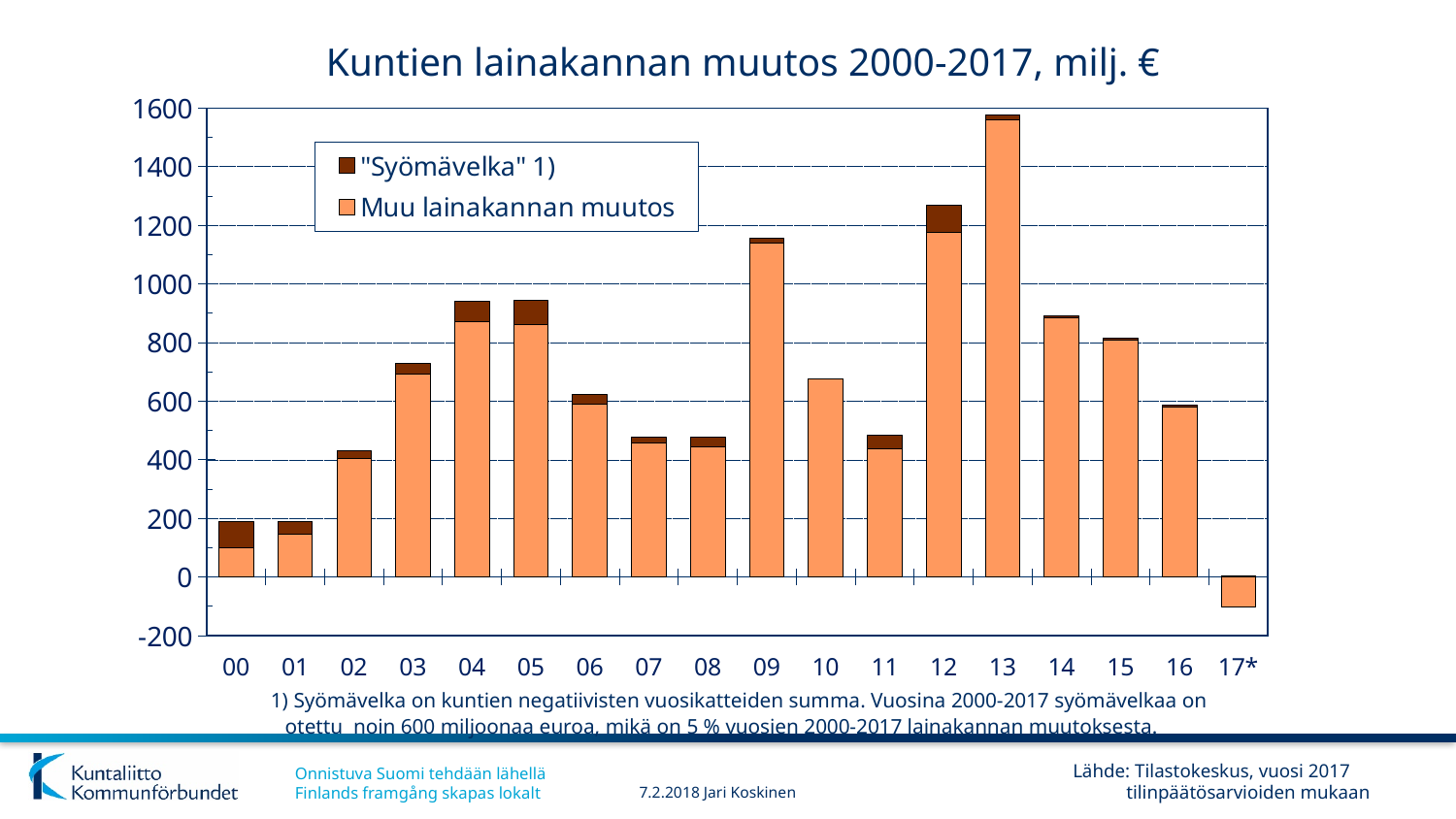
Which year has the highest total change in loan stock? 13 What is the title of the chart? Kuntien lainakannan muutos 2000-2017, milj. € How many series does the legend list? 2 Which year has the larger total, 12 or 09? 12 Do the total values rise or fall from 13 to 17*? fall Is the value for 17* greater or less than 0? less Is the total value for 09 greater or less than 1000? greater Which year has the lowest total change in loan stock? 17* Is the total value for 13 greater or less than 1400? greater What kind of chart is shown on the slide? stacked bar chart How many years (categories) are shown on the x axis? 18